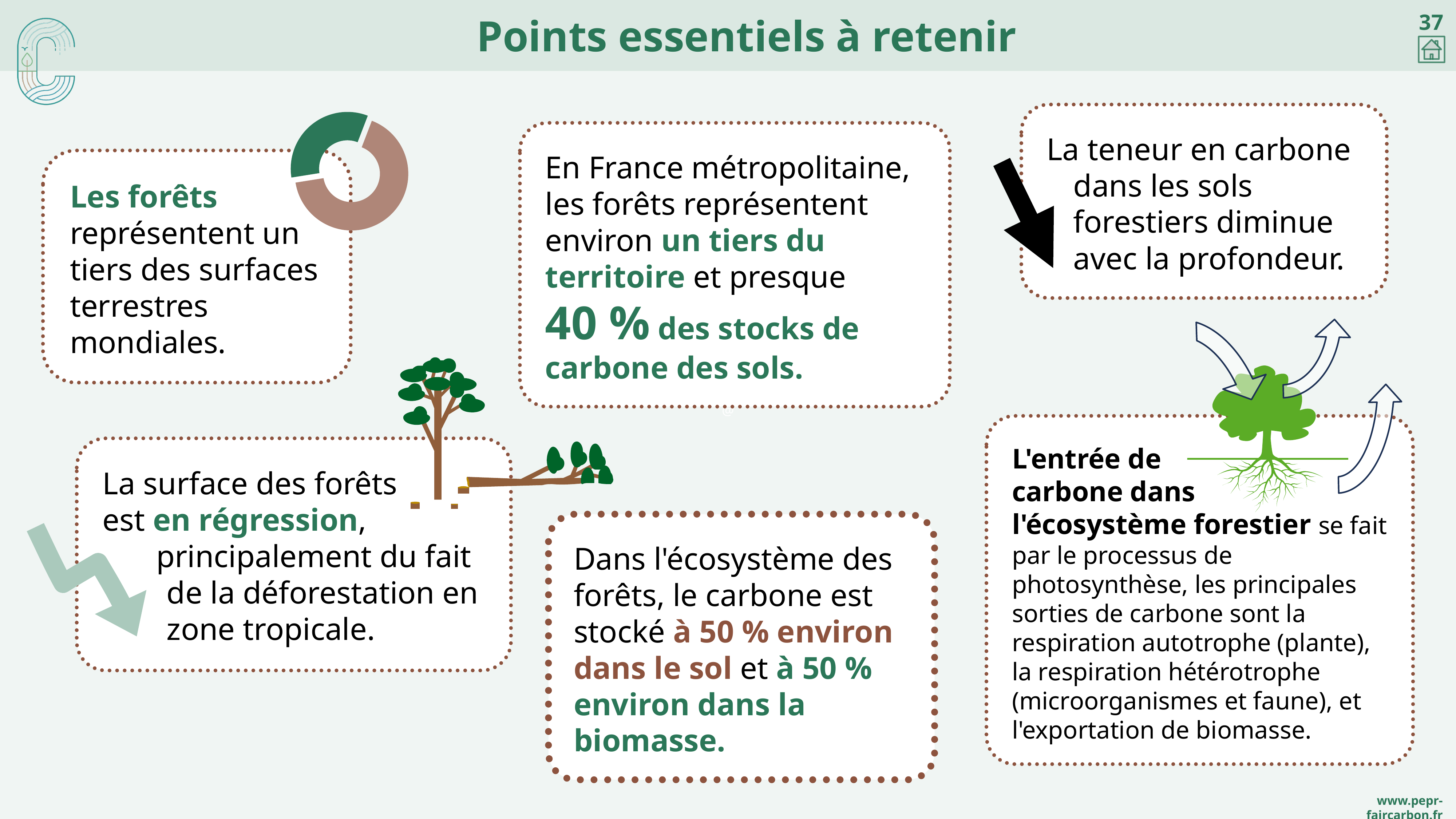
In the pie chart in the top-left of the slide, which colour slice is the smallest? green How many slices does the pie chart in the top-left of the slide have? 2 In the pie chart in the top-left of the slide, which colour slice is the largest? brown Does the pie chart in the top-left of the slide have a legend? No What kind of chart is shown in the top-left of the slide, next to the 'Les forêts' text box? doughnut chart Which two colours are used for the slices of the pie chart in the top-left of the slide? green and brown In the pie chart in the top-left of the slide, which slice is larger, the green one or the brown one? the brown one